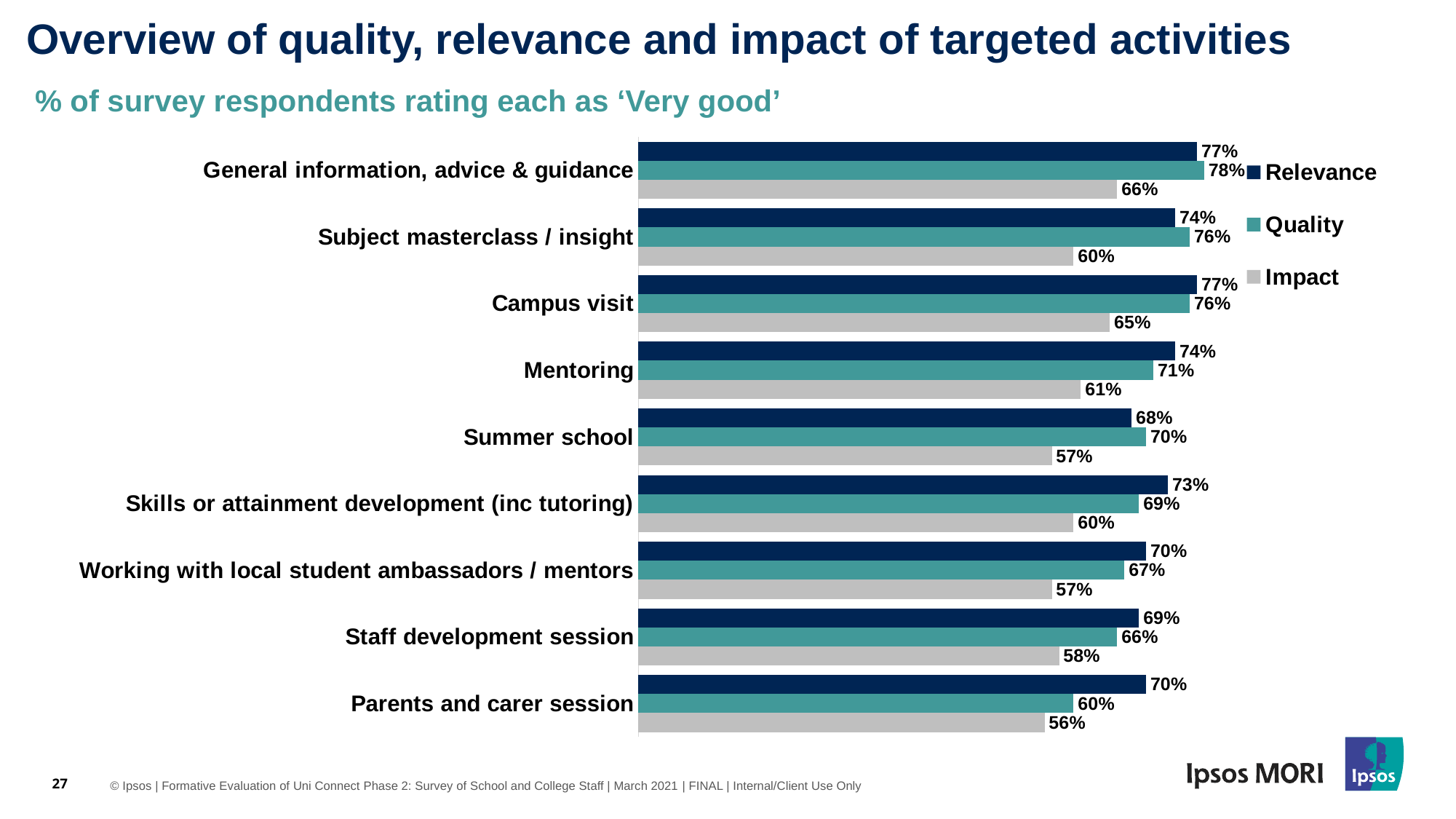
How many activities are shown on the chart? 9 How many series does the legend list? 3 What percentage of respondents rated the Quality of General information, advice & guidance as 'Very good'? 78% What is the difference between the Relevance and Impact values for Subject masterclass / insight? 14 percentage points What is the Relevance value for Skills or attainment development (inc tutoring)? 73% Which series is shown in grey in the legend? Impact Which activity has the highest Quality rating? General information, advice & guidance What kind of chart is shown on the slide? Bar chart Which activity has the lowest Relevance rating? Summer school For Parents and carer session, which is larger: the Relevance value or the Quality value? Relevance What is the Impact value for Parents and carer session? 56% Which activity has the lowest Impact rating? Parents and carer session